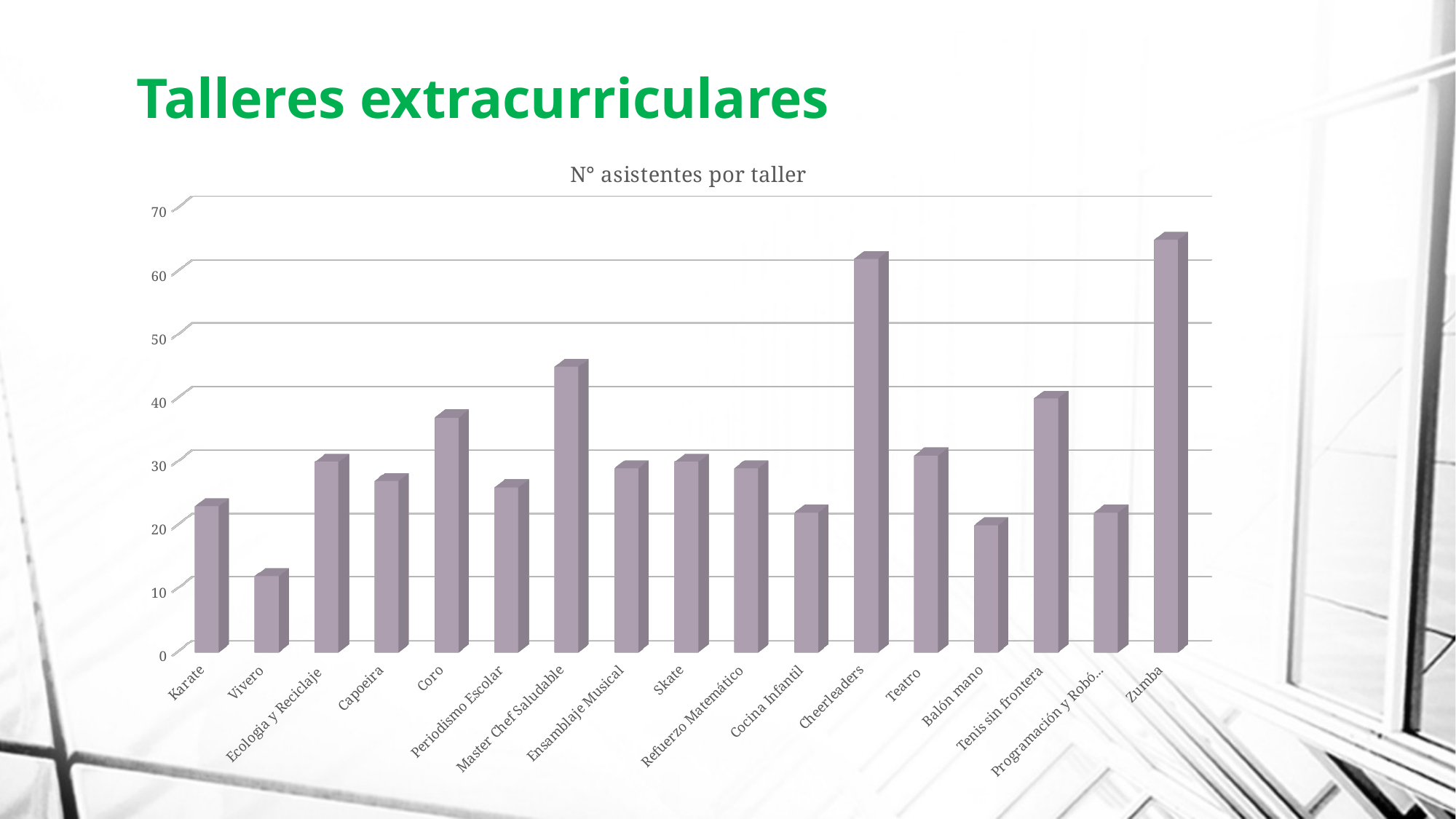
Is the value for Master Chef Saludable greater or less than 40? greater Which has more asistentes, Coro or Capoeira? Coro Is the value for Coro greater or less than 30? greater What is the title of the chart? N° asistentes por taller Is the value for Capoeira greater or less than 30? less How many talleres are shown on the x axis? 17 Which has more asistentes, Master Chef Saludable or Tenis sin frontera? Master Chef Saludable Which taller has the lowest number of asistentes? Vivero Which taller has the highest number of asistentes? Zumba What kind of chart is shown on the slide? Bar chart